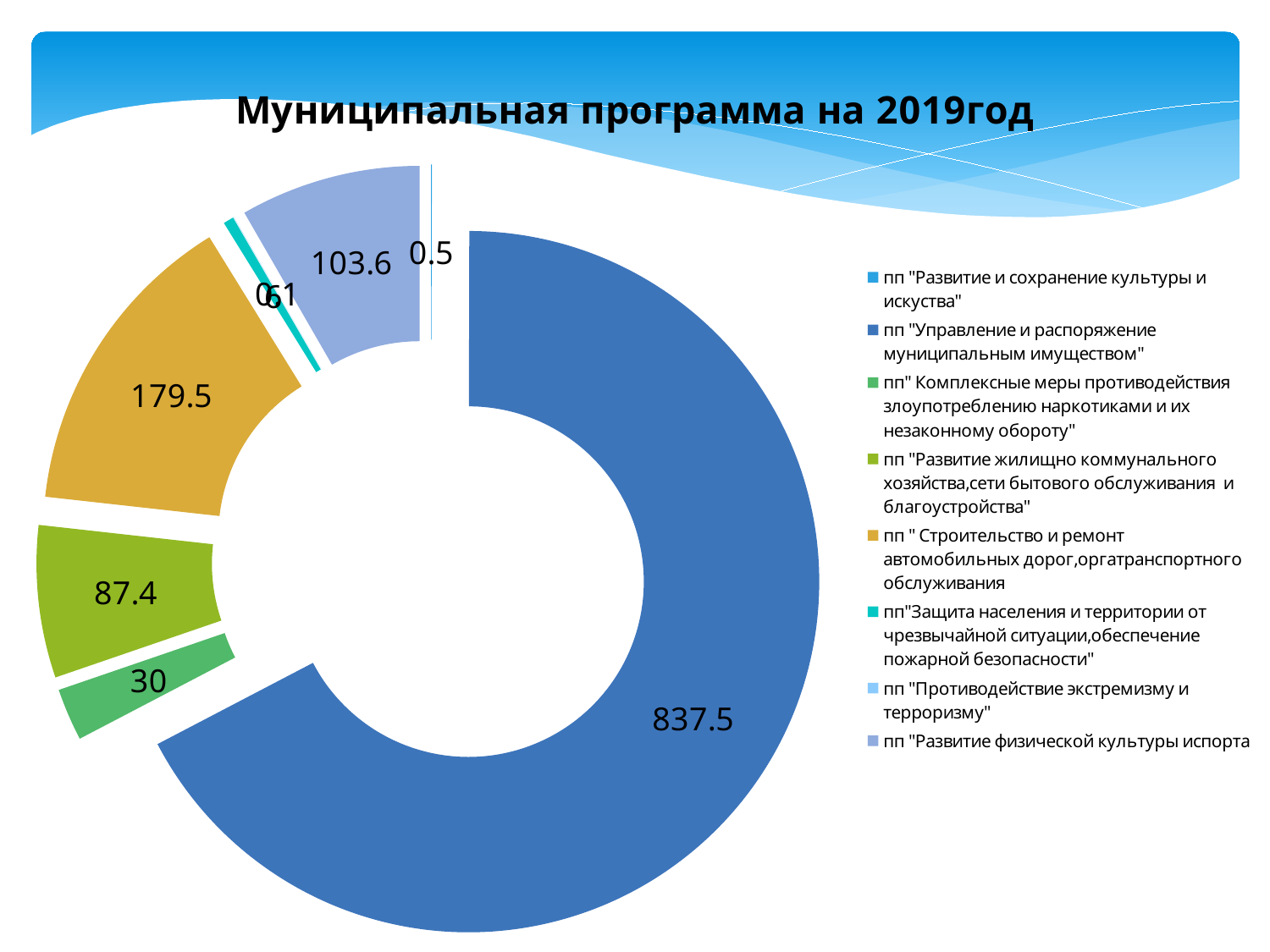
Which program has the largest slice in the chart? пп "Управление и распоряжение муниципальным имуществом" What is the difference between the values for road construction (179.5) and housing and communal services (87.4)? 92.1 What is the value for пп "Развитие жилищно коммунального хозяйства, сети бытового обслуживания и благоустройства"? 87.4 What kind of chart is shown on the slide? Doughnut (pie) chart What is the value for пп "Комплексные меры противодействия злоупотреблению наркотиками и их незаконному обороту"? 30 What is the value for пп "Строительство и ремонт автомобильных дорог, оргатранспортного обслуживания"? 179.5 What is the value for пп "Развитие и сохранение культуры и искуства"? 0.5 How many entries does the legend list? 8 What is the title of the chart? Муниципальная программа на 2019год What is the value for пп "Противодействие экстремизму и терроризму"? 0.1 What is the value for пп "Развитие физической культуры и спорта"? 103.6 Which is larger: the value for physical culture and sport or the value for housing and communal services? Physical culture and sport (103.6)